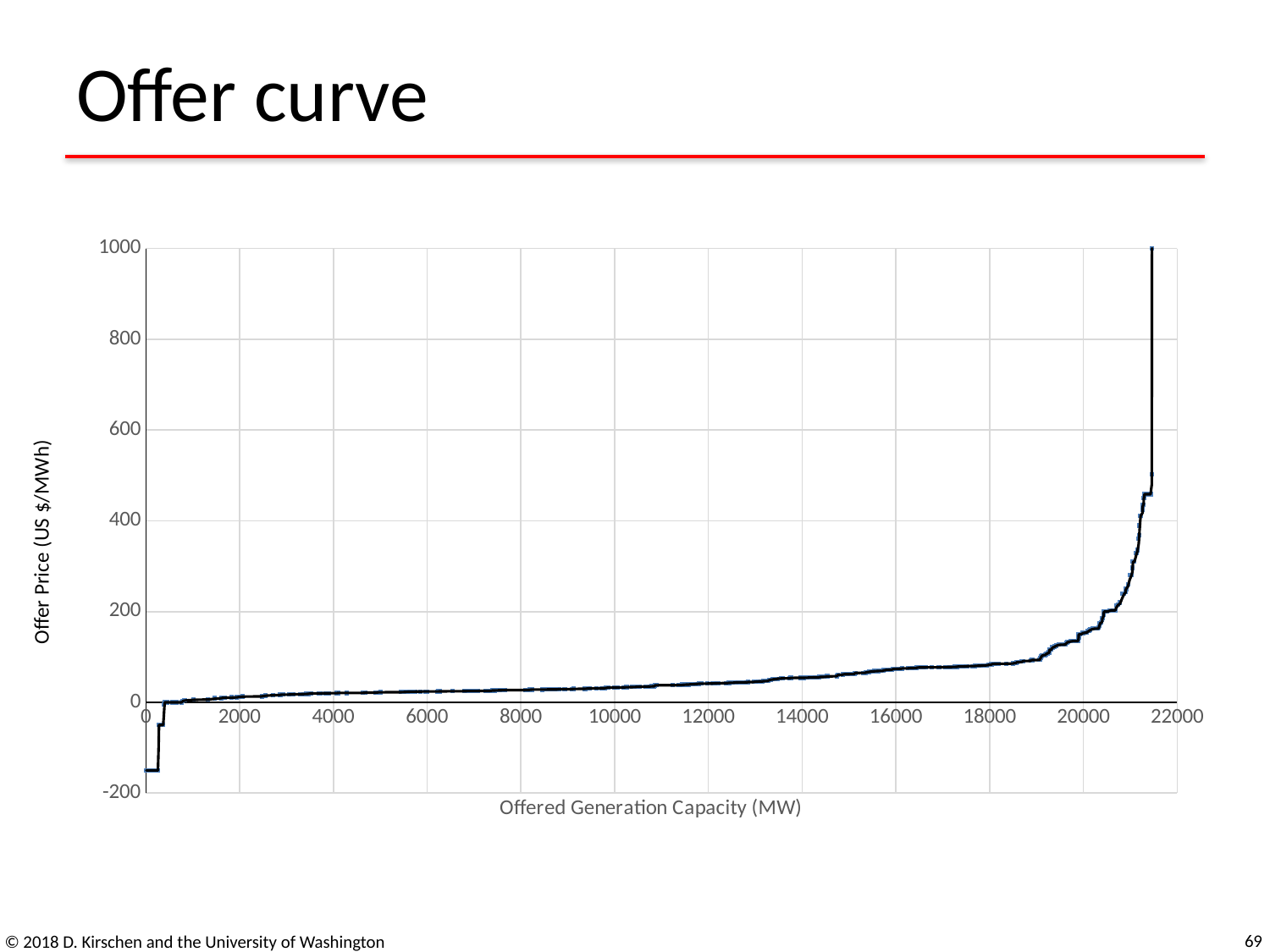
Is the lowest offer price on the curve greater or less than -100 US $/MWh? less Is the offer price at 10000 MW of offered generation capacity greater or less than 200 US $/MWh? less Is the offer price at 20000 MW of offered generation capacity greater or less than 400 US $/MWh? less What is the label of the y axis of the chart? Offer Price (US $/MWh) Is the offer price at 10000 MW greater or less than the offer price at 20000 MW? less What kind of chart is shown on the slide? line chart Does the offer price rise or fall as offered generation capacity increases along the x axis? rise What is the label of the x axis of the chart? Offered Generation Capacity (MW)